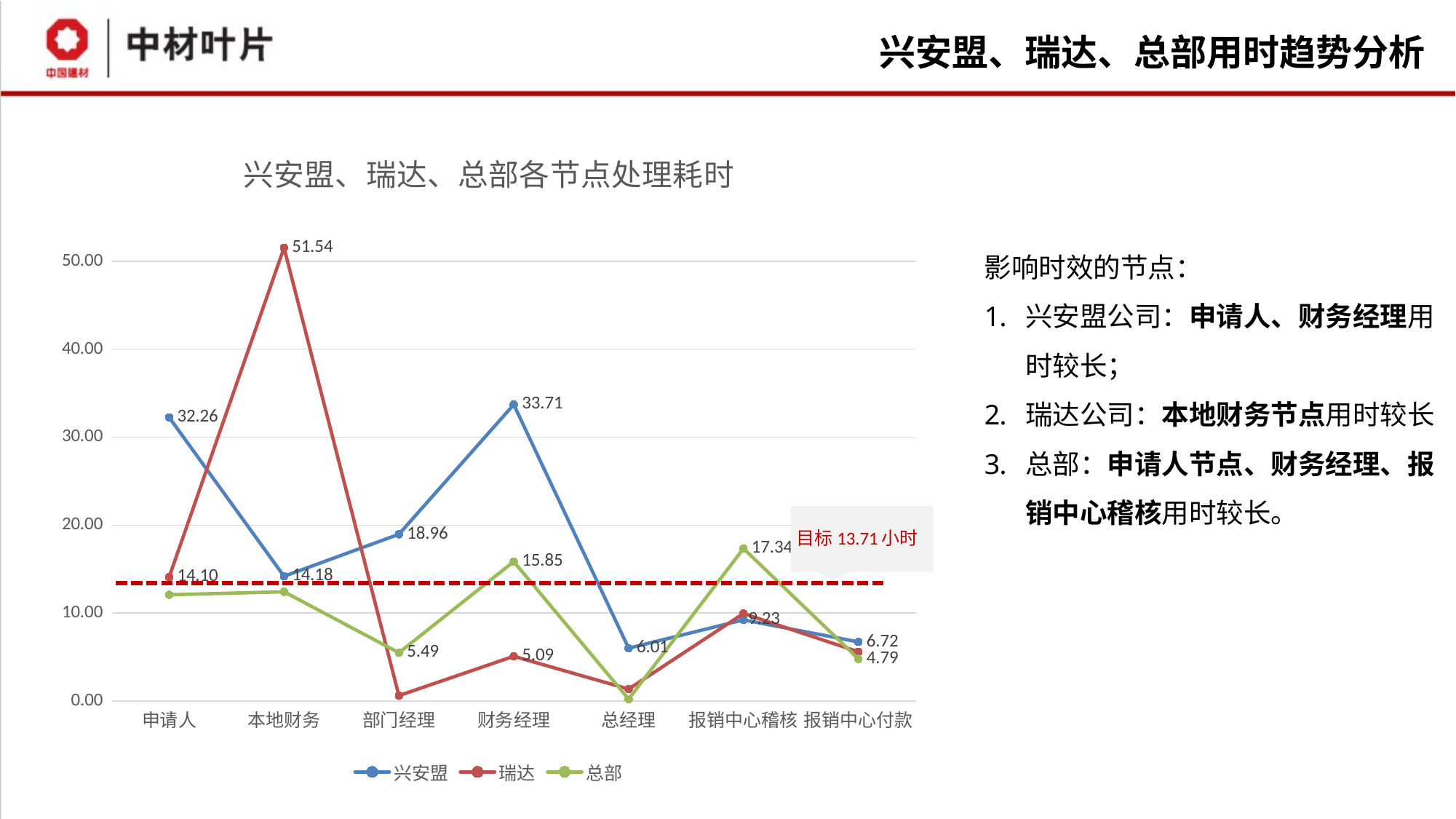
How many series does the legend list? 3 Is the value for 总部 at the 申请人 node greater or less than 20.00? less What is the value for 瑞达 at the 本地财务 node? 51.54 How many nodes (categories) are shown on the x axis? 7 What is the value for 总部 at the 部门经理 node? 5.49 At the 申请人 node, which series has the larger value, 兴安盟 or 瑞达? 兴安盟 At which node does the 兴安盟 series reach its highest value? 财务经理 What is the difference between the 兴安盟 values at 财务经理 and 部门经理? 14.75 What is the value for 兴安盟 at the 申请人 node? 32.26 What is the value for 总部 at the 报销中心稽核 node? 17.34 What type of chart is shown on the slide? line chart At which node does the 瑞达 series reach its highest value? 本地财务